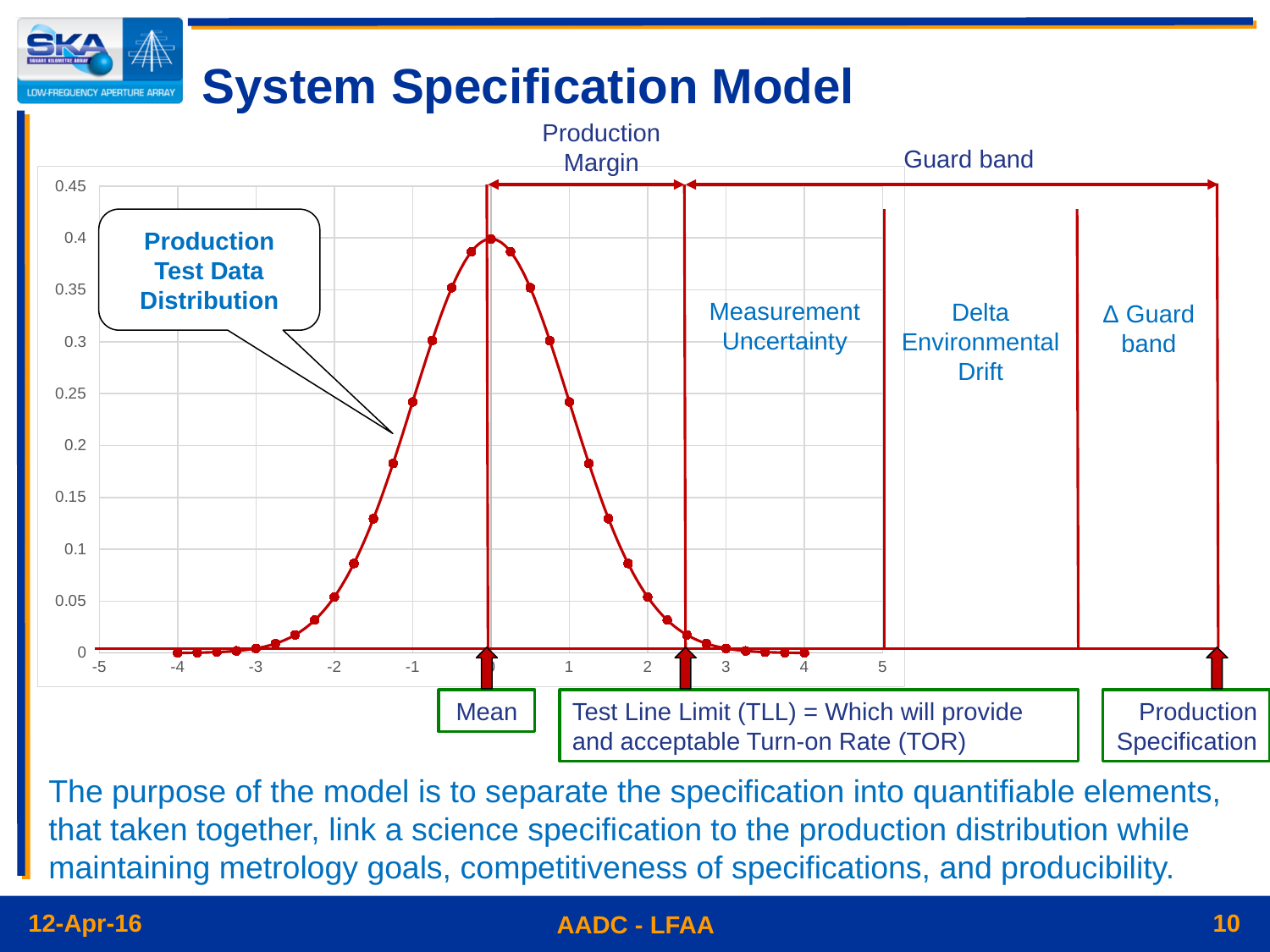
Is the value of the distribution at x = 3 greater or less than 0.05? less Is the value of the distribution at x = -1 greater or less than 0.2? greater Is the peak value of the distribution at x = 0 greater or less than 0.35? greater What kind of chart is shown on the slide? line chart Do the plotted values rise or fall as x increases from -5 to 0? rise Do the plotted values rise or fall as x increases from 0 to 5? fall What is the highest value shown on the y axis? 0.45 At which x-axis value does the plotted distribution reach its highest point? 0 Which is larger, the value of the distribution at x = -1 or at x = 2? x = -1 What does the callout box pointing at the curve label the plotted data as? Production Test Data Distribution